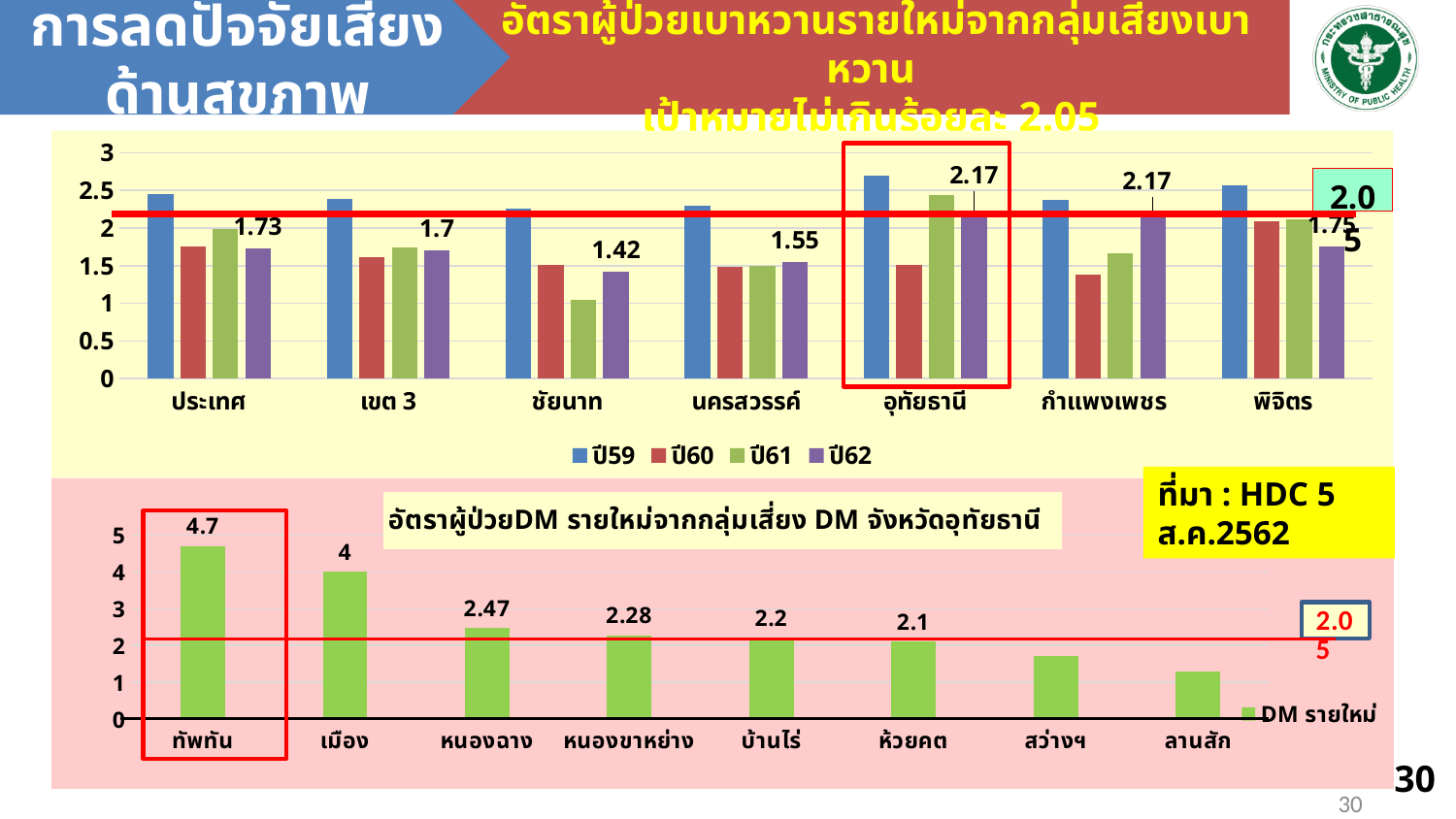
In the top chart, how many categories are shown on the x axis? 7 In the top chart, how many series does the legend list? 4 In the top chart, what is the ปี62 value for อุทัยธานี? 2.17 In the top chart, what is the difference between the ปี62 values for อุทัยธานี and ชัยนาท? 0.75 In the top chart, what is the ปี62 value for ชัยนาท? 1.42 What kind of chart is the bottom chart? Bar chart In the bottom chart, how many categories are shown on the x axis? 8 In the top chart, is the ปี59 value for ประเทศ greater or less than 2? greater In the bottom chart, is the value for ลานสัก greater or less than 2? less In the bottom chart, what is the difference between the values for ทัพทัน and เมือง? 0.7 In the bottom chart, which category has the highest value? ทัพทัน In the bottom chart, what is the value for ทัพทัน? 4.7